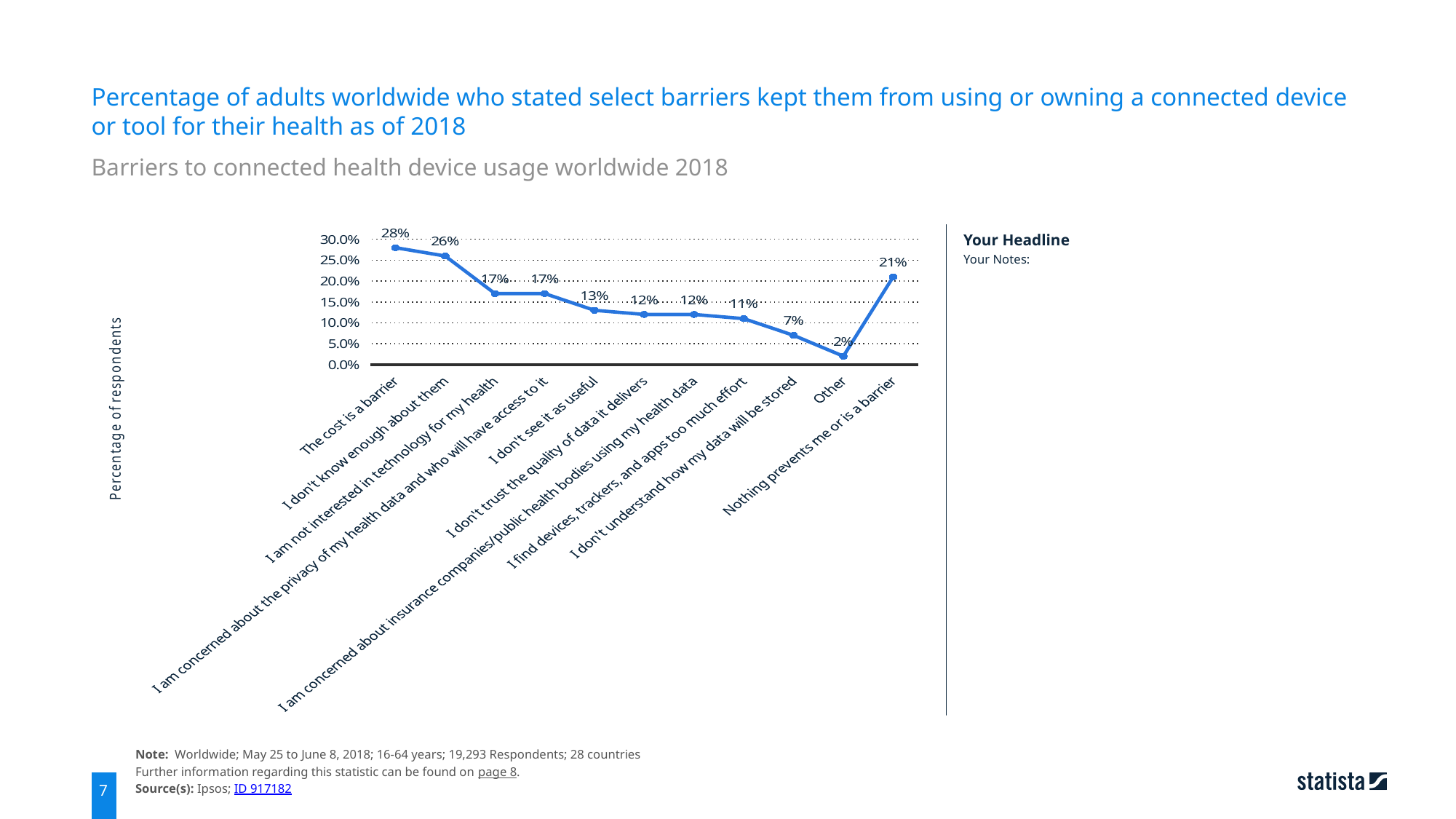
What percentage of respondents chose 'Other' as a barrier? 2% Which category has the lowest percentage of respondents? Other What percentage of respondents said they don't understand how their data will be stored? 7% How many categories are plotted on the chart? 11 What type of chart is shown on the slide? Line chart What is the difference in percentage points between 'The cost is a barrier' and 'I don't see it as useful'? 15 Which has a higher percentage: 'I don't know enough about them' or 'Nothing prevents me or is a barrier'? I don't know enough about them Which barrier has the highest percentage of respondents? The cost is a barrier What is the label of the vertical axis? Percentage of respondents What percentage of respondents stated that cost is a barrier? 28% What percentage of respondents said nothing prevents them or is a barrier? 21% What percentage of respondents said they don't know enough about connected health devices? 26%